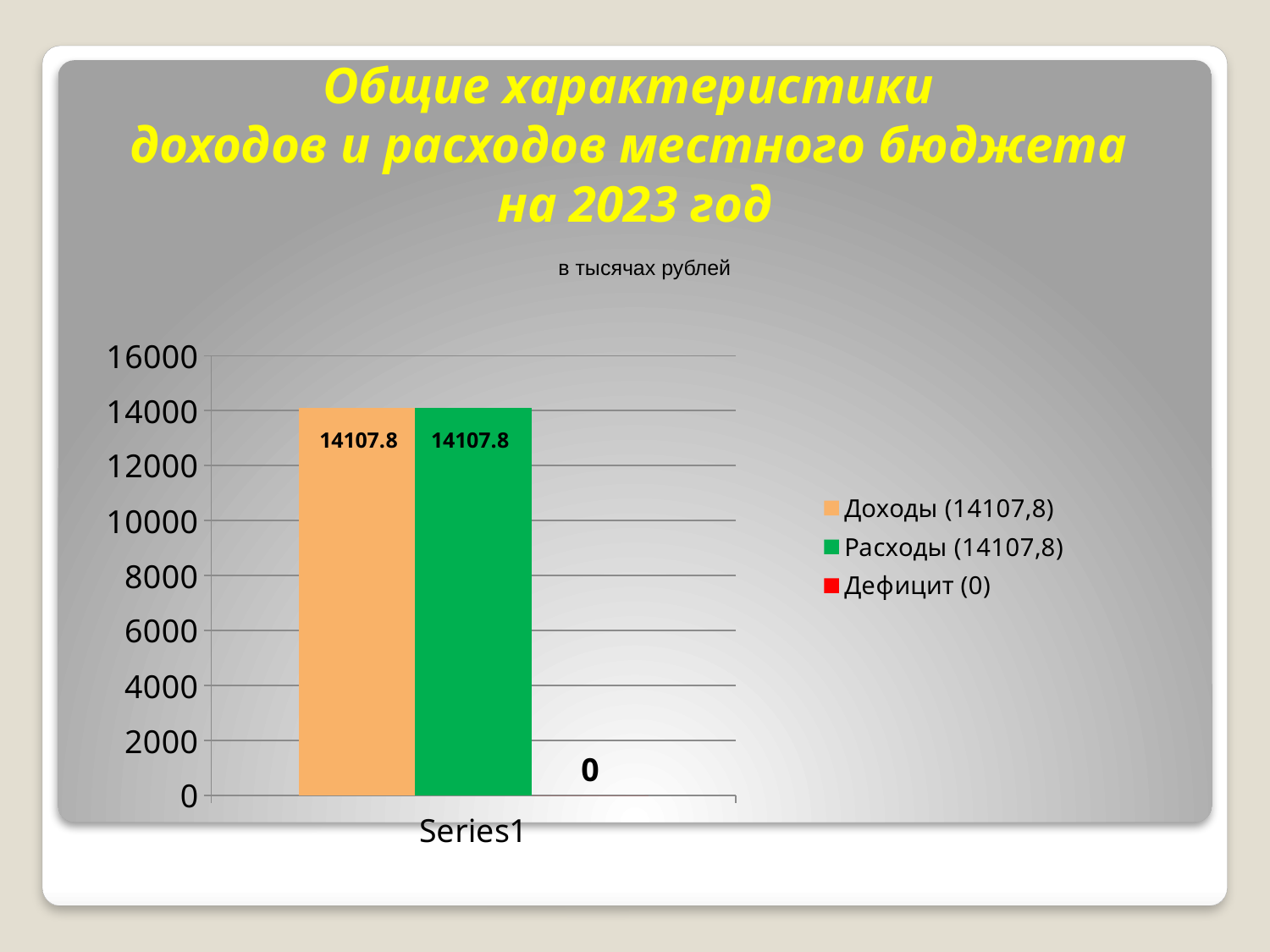
What kind of chart is shown on the slide? bar chart What is the value of the Расходы bar? 14107.8 What is the category label shown on the x axis? Series1 What unit is stated in the chart title above the plot? в тысячах рублей What is the difference between the Доходы and Расходы values? 0 Is the value for Доходы greater or less than 16000? less Is the value for Расходы greater or less than 12000? greater How many series does the legend list? 3 What is the value of the Доходы bar? 14107.8 Which series has the lowest value? Дефицит What is the value shown for Дефицит? 0 What is the difference between the Доходы value and the Дефицит value? 14107.8